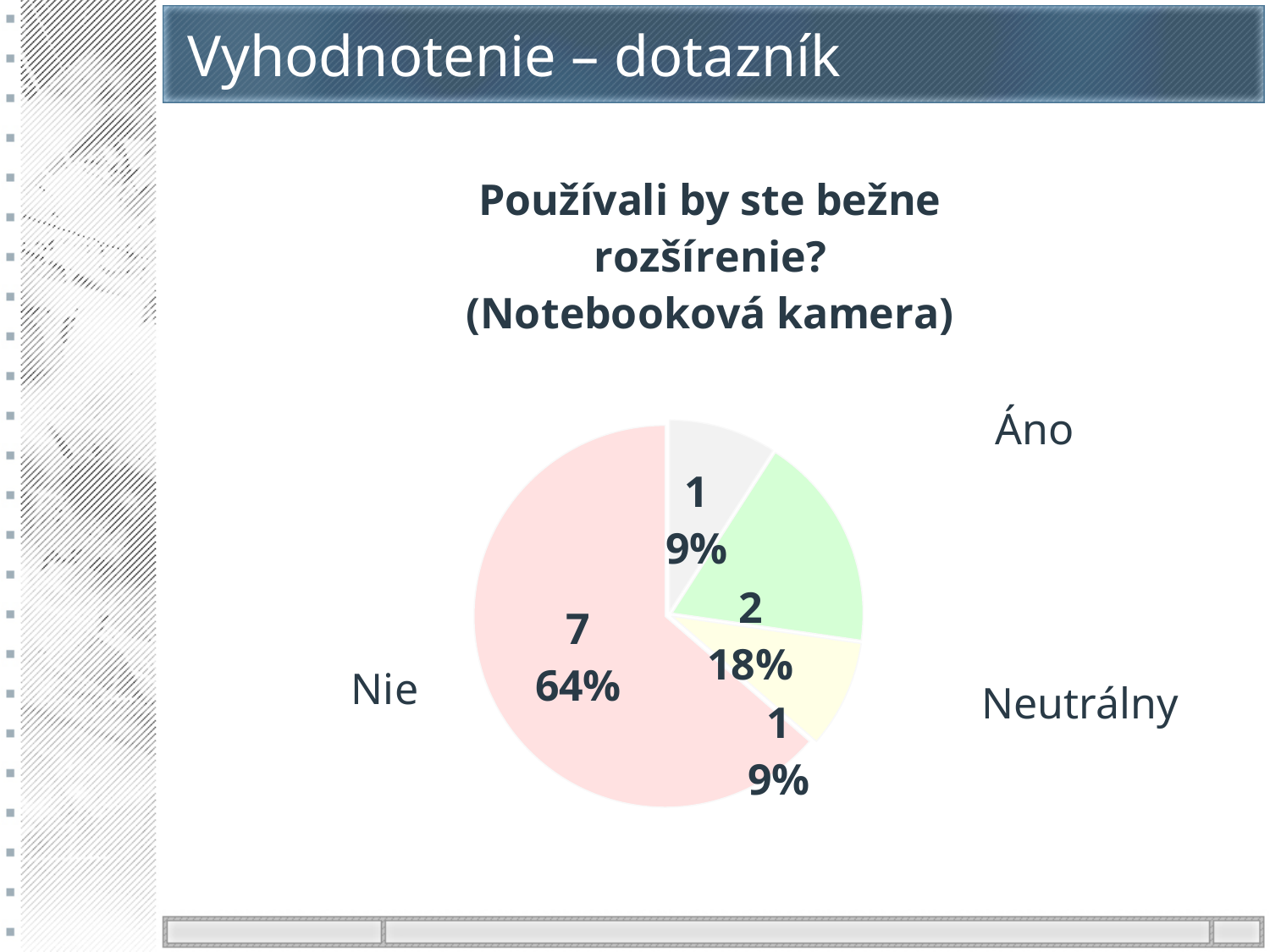
What kind of chart is shown on the slide? pie chart What is the title of the chart? Používali by ste bežne rozšírenie? (Notebooková kamera) What share of the pie does "Áno" represent? 18% What share of the pie does "Neutrálny" represent? 9% How many respondents answered "Neutrálny"? 1 What share of the pie does "Nie" represent? 64% What is the difference between the number of "Nie" responses and the number of "Áno" responses? 5 Which answer has the largest slice of the pie? Nie Which is larger, the slice for "Áno" or the slice for "Neutrálny"? Áno How many respondents answered "Áno"? 2 How many slices does the pie chart have? 4 How many respondents answered "Nie"? 7